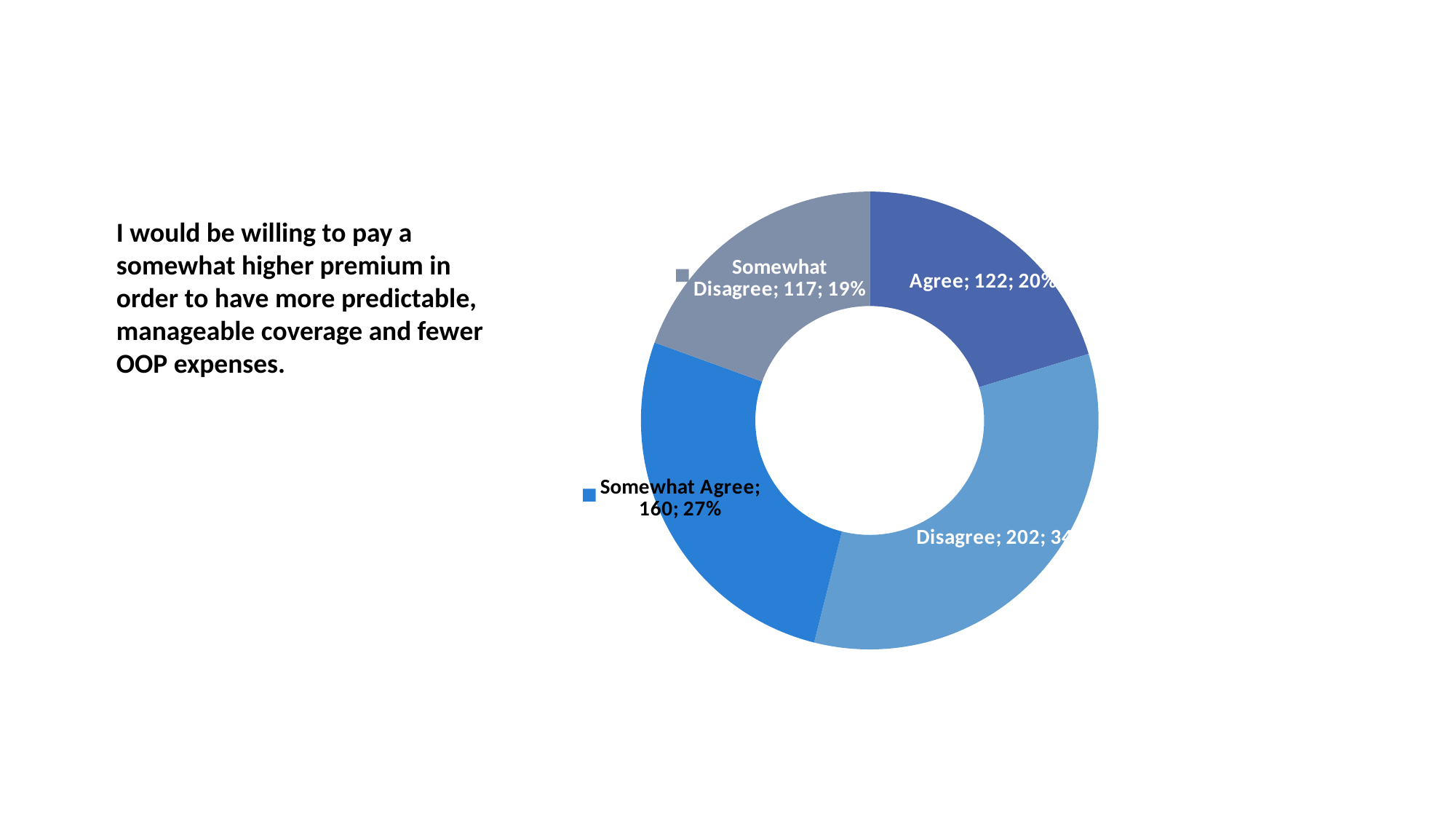
Which is larger, the count for "Agree" or the count for "Somewhat Disagree"? Agree How many respondents chose "Disagree"? 202 What is the difference between the counts for "Disagree" and "Somewhat Agree"? 42 How many categories does the doughnut chart show? 4 How many respondents chose "Agree"? 122 How many respondents chose "Somewhat Disagree"? 117 Which category has the largest slice? Disagree How many respondents chose "Somewhat Agree"? 160 What type of chart is shown on the slide? Doughnut chart Which category has the smallest slice? Somewhat Disagree What share of the doughnut does "Somewhat Disagree" represent? 19% What share of the doughnut does "Somewhat Agree" represent? 27%